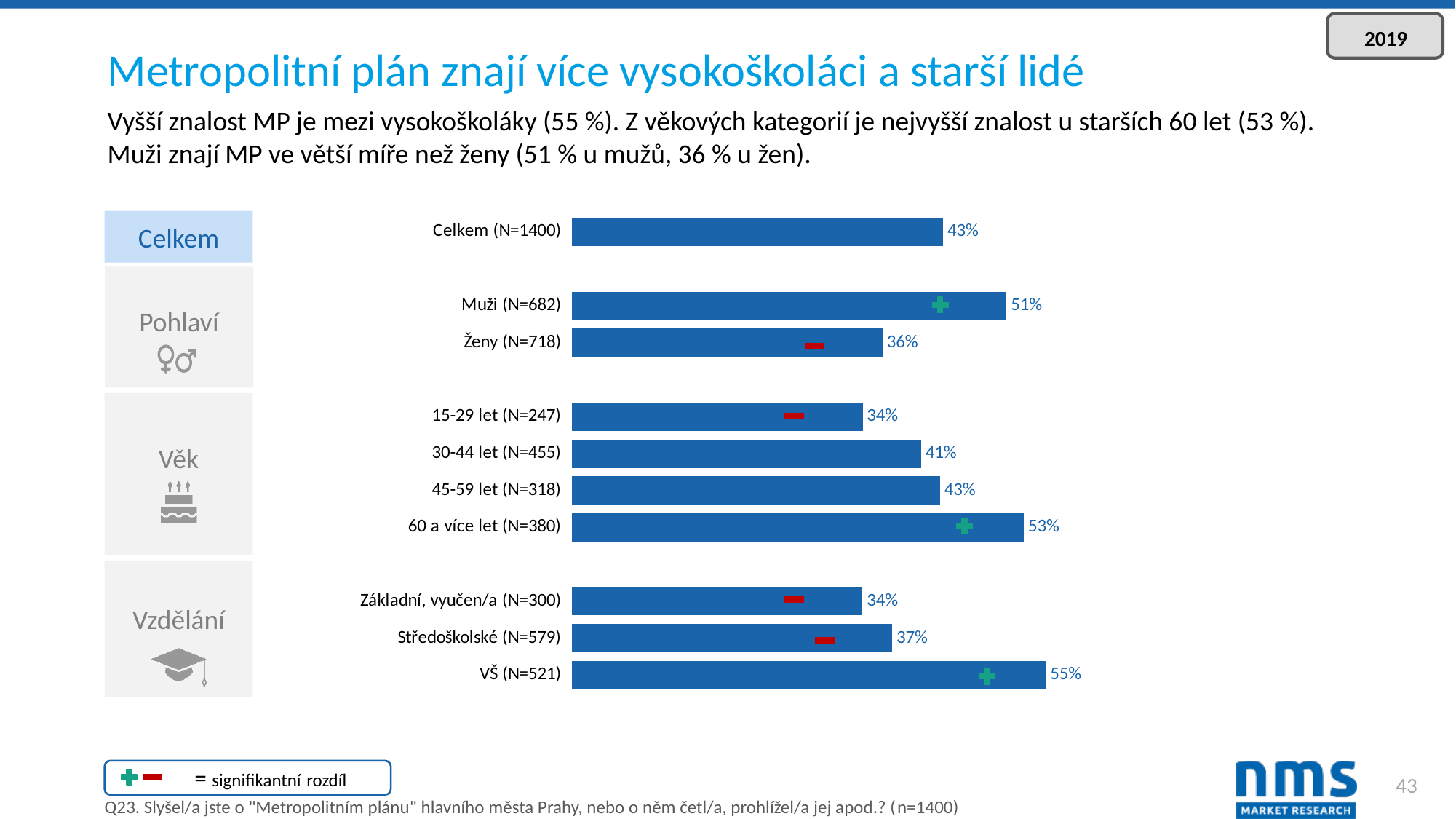
What do the green plus and red minus markers on the bars indicate, according to the legend? signifikantní rozdíl What is the difference between the values for Muži (N=682) and Ženy (N=718)? 15% What is the value for 60 a více let (N=380)? 53% What kind of chart is shown on the slide? bar chart Which category has the highest value? VŠ (N=521) Which age category (Věk) has the lowest value? 15-29 let (N=247) What is the value for Ženy (N=718)? 36% What is the value for Celkem (N=1400)? 43% What is the difference between the values for VŠ (N=521) and Základní, vyučen/a (N=300)? 21% What is the value for Středoškolské (N=579)? 37% Which is larger, the value for 30-44 let (N=455) or 45-59 let (N=318)? 45-59 let (N=318) How many bars are shown in the chart? 10